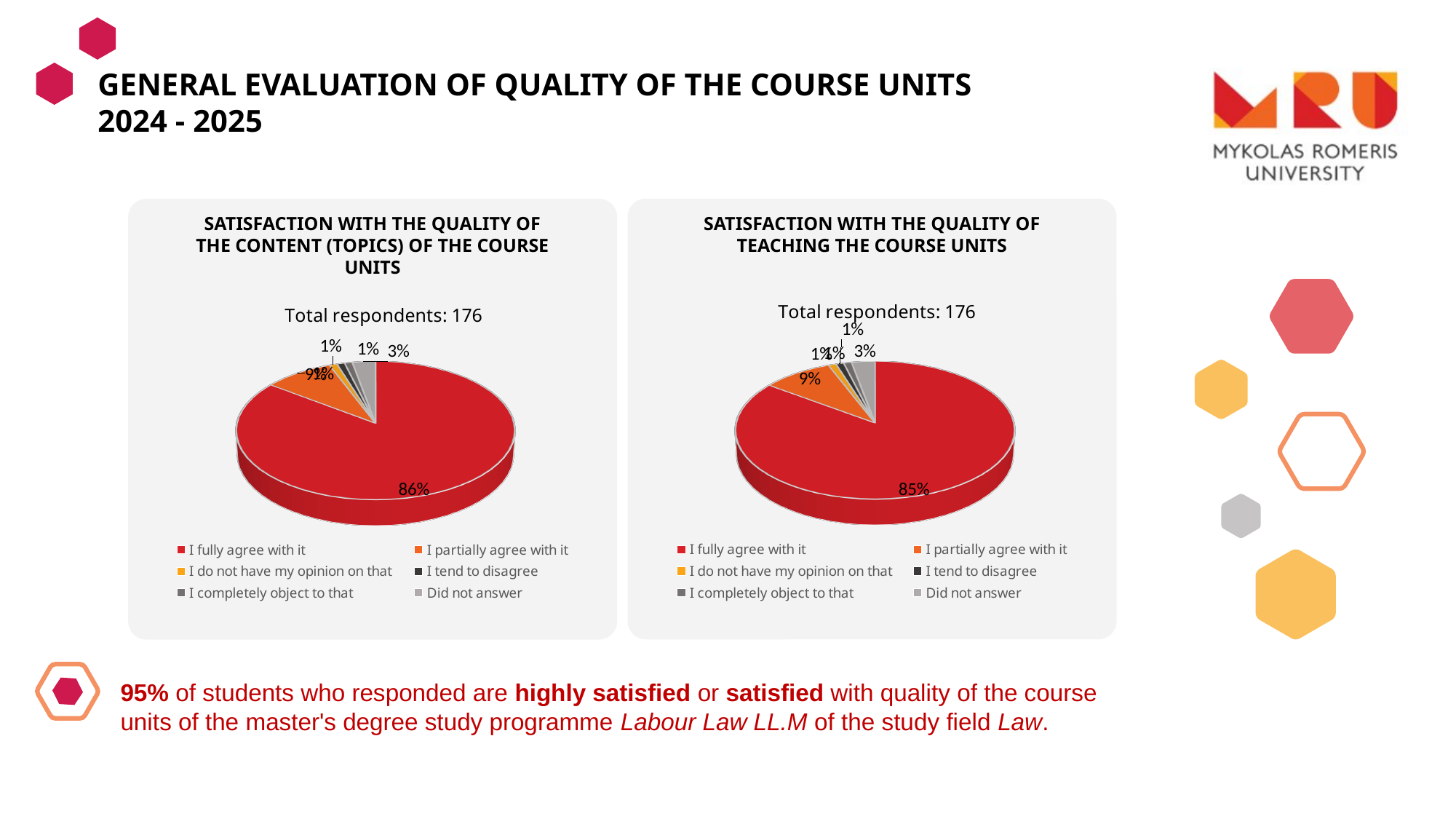
What type of chart is used in the 'Satisfaction with the quality of teaching the course units' panel? Pie chart In the left chart (content of the course units), what share of respondents chose 'I partially agree with it'? 9% In the right chart (teaching the course units), what share of respondents chose 'I partially agree with it'? 9% In the left chart (content of the course units), what is the difference in percentage points between 'I fully agree with it' and 'I partially agree with it'? 77 percentage points In the chart titled 'Satisfaction with the quality of teaching the course units', what percentage of respondents chose 'I fully agree with it'? 85% In the right chart (teaching the course units), which response category has the largest slice? I fully agree with it In the left chart (content of the course units), what percentage is shown for 'Did not answer'? 3% How many total respondents are reported for the chart on the right (teaching the course units)? 176 How many response categories does the legend of the left chart (content of the course units) list? 6 In the left chart (content of the course units), what colour is the slice for 'I fully agree with it'? Red In the chart titled 'Satisfaction with the quality of the content (topics) of the course units', what percentage of respondents chose 'I fully agree with it'? 86% Which chart shows a larger share for 'I fully agree with it': the content chart on the left or the teaching chart on the right? The content chart on the left (86%)